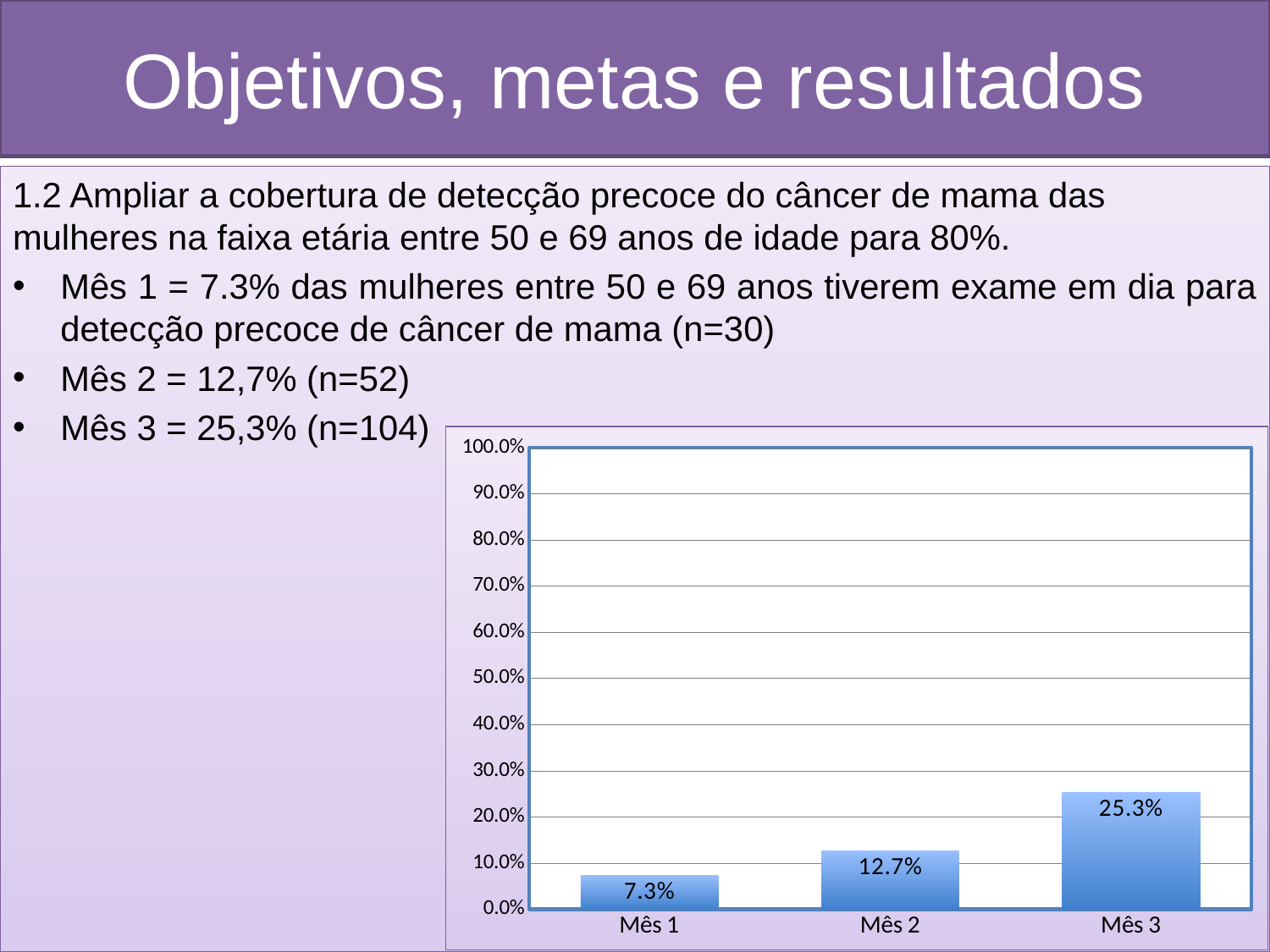
How many categories are shown on the x axis of the chart? 3 What kind of chart is shown on the slide? bar chart What is the difference between the values for Mês 3 and Mês 2? 12.6% Which category has the lowest value in the chart? Mês 1 Which is larger, the value for Mês 2 or the value for Mês 3? Mês 3 Do the values rise or fall from Mês 1 to Mês 3? rise Which category has the highest value in the chart? Mês 3 What is the difference between the values for Mês 2 and Mês 1? 5.4% Is the value for Mês 3 greater or less than 30.0%? less What is the value for Mês 2 in the chart? 12.7% What is the value for Mês 3 in the chart? 25.3% What is the value for Mês 1 in the chart? 7.3%